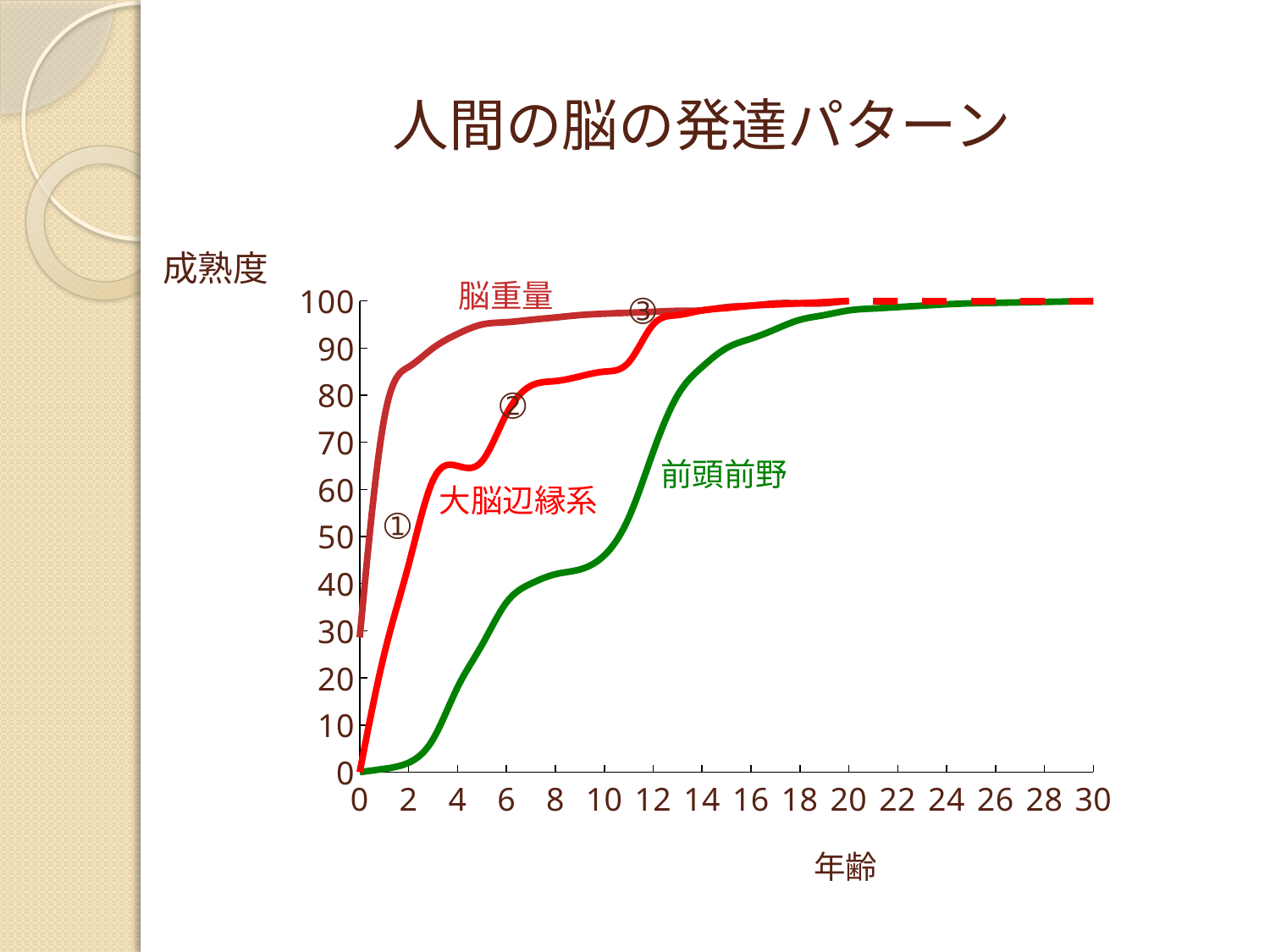
Which curve has the highest value at age 4? 脳重量 Is the value for 大脳辺縁系 at age 4 greater or less than 60? greater What is the label of the x axis? 年齢 How many curves (series) are plotted on the chart? 3 What kind of chart is shown on the slide? line chart Is the value for 前頭前野 at age 14 greater or less than 80? greater Which curve has the lowest value at age 10? 前頭前野 Is the value for 脳重量 at age 2 greater or less than 80? greater What is the title of the chart? 人間の脳の発達パターン Does the 前頭前野 curve rise or fall as age increases along the x axis? rise At age 6, which curve is higher, 大脳辺縁系 or 前頭前野? 大脳辺縁系